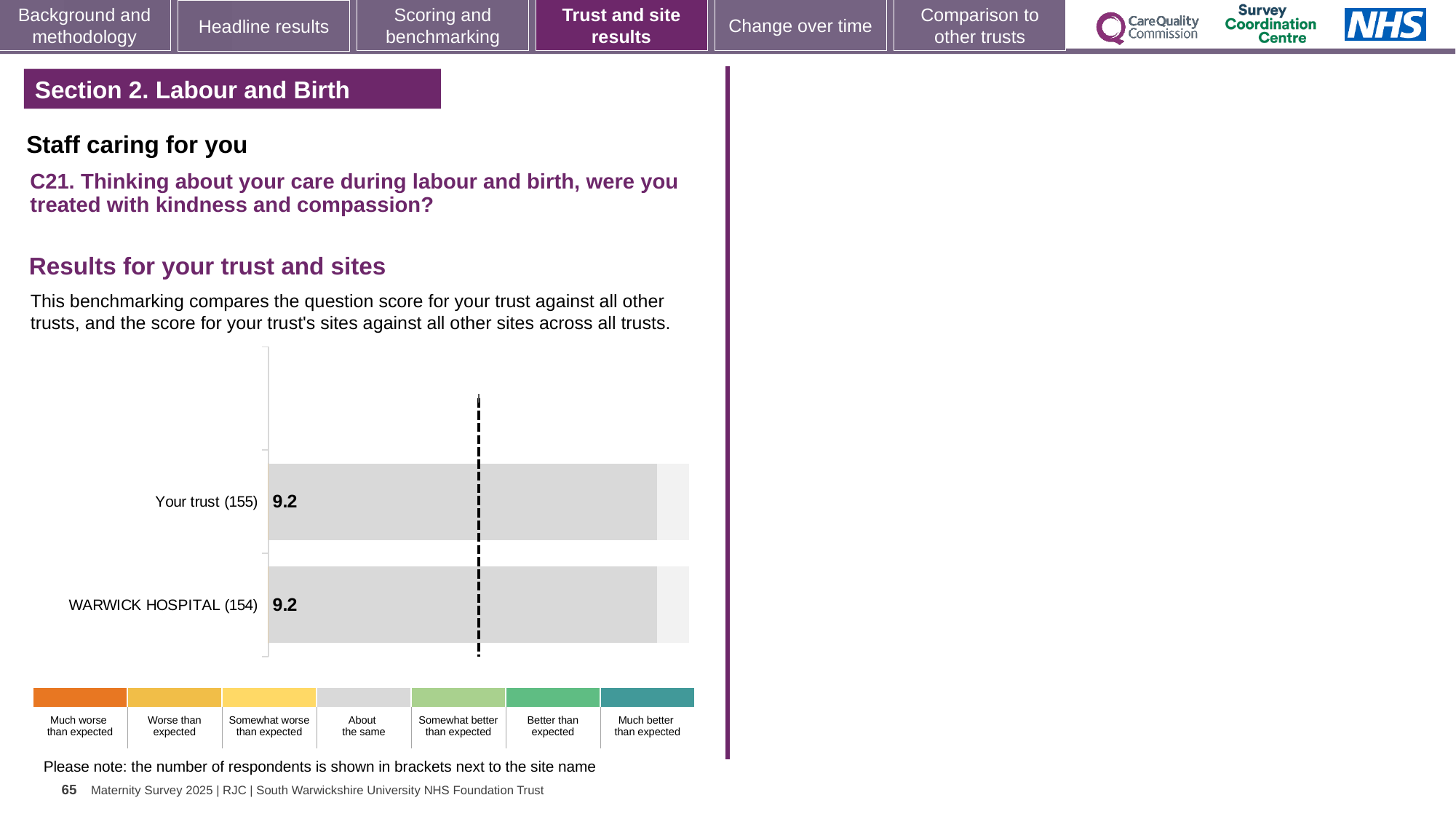
What kind of chart is shown on the slide? Bar chart How many respondents are shown in brackets for WARWICK HOSPITAL? 154 Which category in the colour key does the grey colour of the bars correspond to? About the same How many respondents are shown in brackets for Your trust? 155 How many bars are plotted in the chart? 2 How many categories does the colour key below the chart list? 7 Is the score for Your trust larger than, smaller than, or equal to the score for WARWICK HOSPITAL? Equal What is the score shown for Your trust? 9.2 What is the score shown for WARWICK HOSPITAL? 9.2 What is the difference between the score for Your trust and the score for WARWICK HOSPITAL? 0